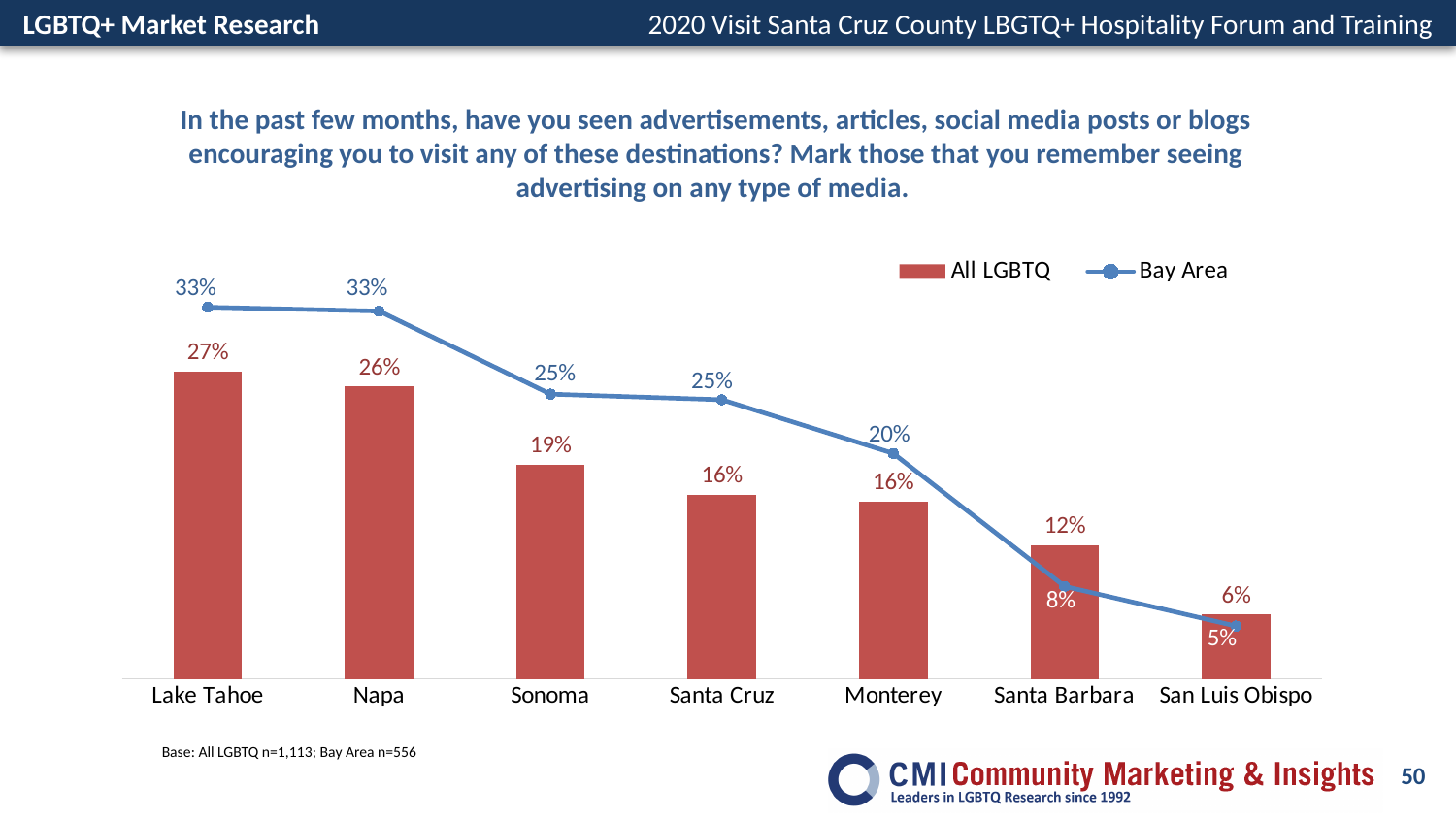
What is the Bay Area value for Monterey? 20% Which destination has the highest All LGBTQ value? Lake Tahoe What is the difference between the Bay Area and All LGBTQ values for Santa Cruz? 9% What is the All LGBTQ value for Santa Barbara? 12% What is the All LGBTQ value for Sonoma? 19% Which is larger for Santa Barbara, the All LGBTQ value or the Bay Area value? All LGBTQ Which series is shown as a line with markers? Bay Area How many destinations are shown on the x axis? 7 Do the All LGBTQ values rise or fall from Lake Tahoe to San Luis Obispo? fall How many series does the legend list? 2 Which destination has the lowest All LGBTQ value? San Luis Obispo What is the Bay Area value for San Luis Obispo? 5%